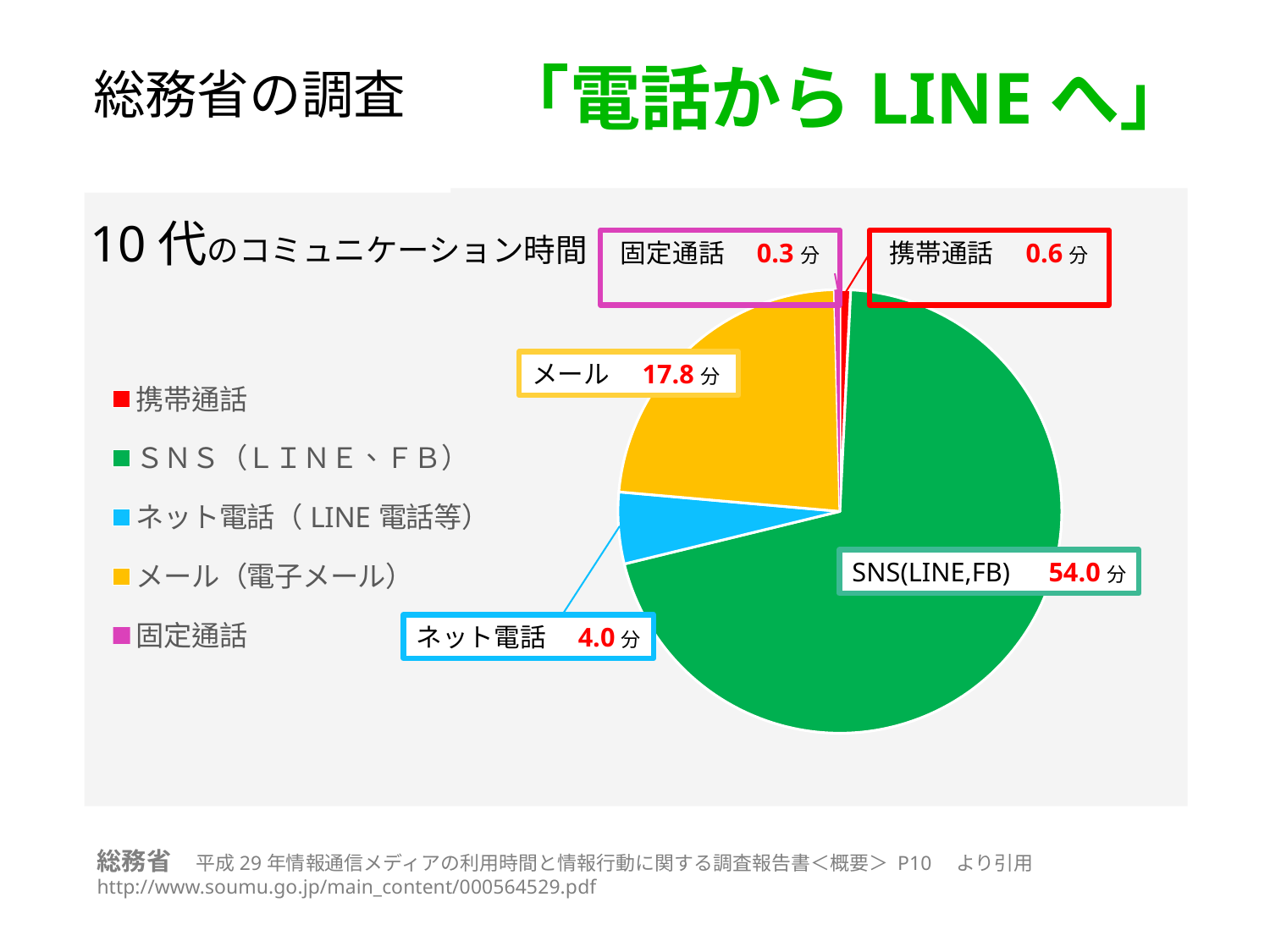
Which category has the largest value in the pie chart? SNS(LINE,FB) Which category has the smallest value in the pie chart? 固定通話 What is the value for 携帯通話 in the pie chart? 0.6分 What is the value for SNS(LINE,FB) in the pie chart? 54.0分 What type of chart is shown on the slide? pie chart What is the value for メール in the pie chart? 17.8分 How many categories does the pie chart have? 5 What colour is the SNS(LINE,FB) slice in the pie chart? green Which is larger, the value for メール or the value for ネット電話? メール What is the value for ネット電話 in the pie chart? 4.0分 What is the value for 固定通話 in the pie chart? 0.3分 What is the difference between the values for SNS(LINE,FB) and メール? 36.2分